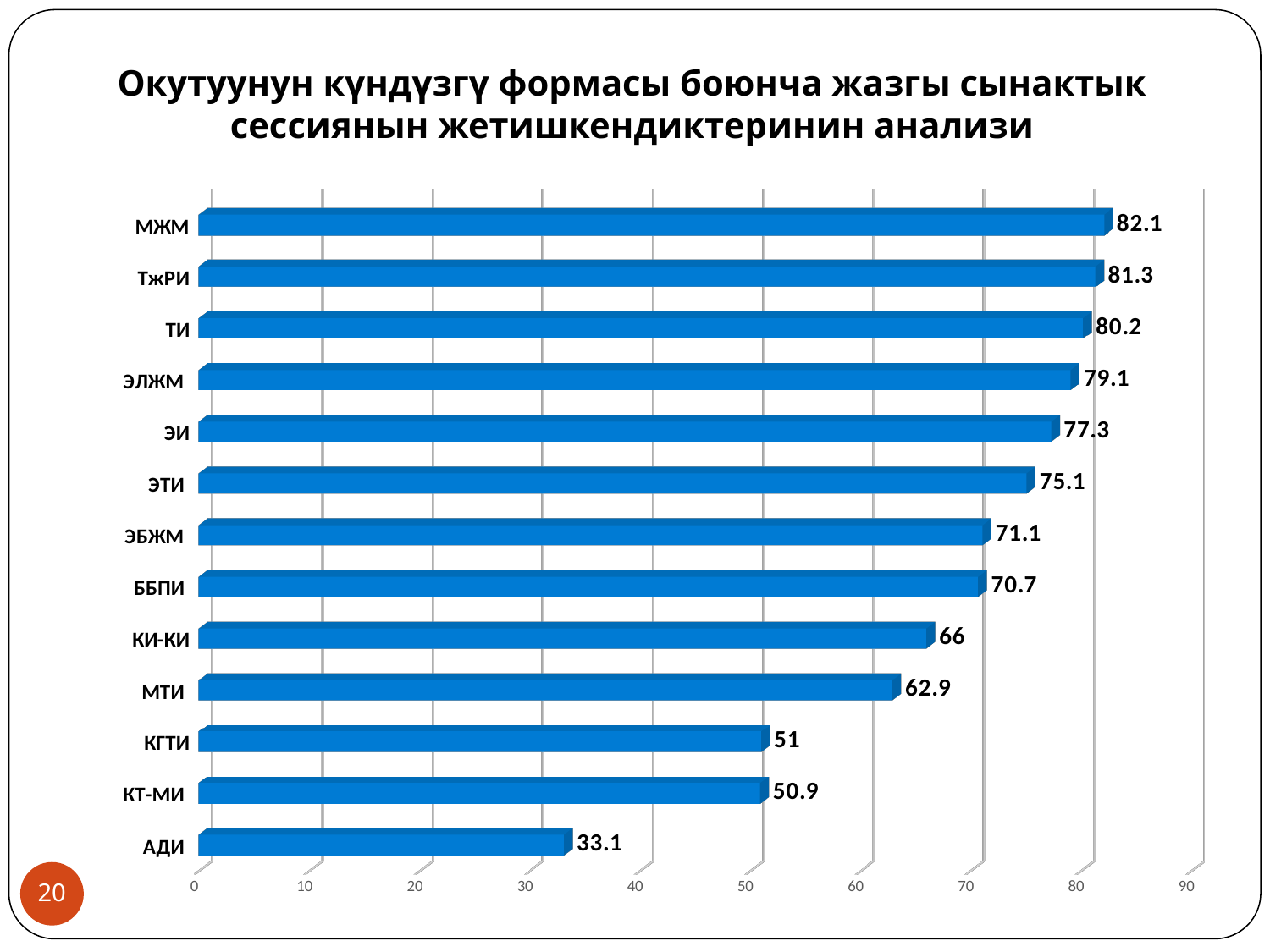
Which is larger, the value for МТИ or the value for КГТИ? МТИ What is the difference between the values for МЖМ and АДИ? 49 What kind of chart is shown on the slide? bar chart How many categories are shown in the chart? 13 What is the value for КИ-КИ? 66 What is the value for МЖМ? 82.1 What is the value for АДИ? 33.1 Which category has the highest value? МЖМ Which category has the lowest value? АДИ What is the difference between the values for ЭТИ and ЭБЖМ? 4 Is the value for ББПИ greater or less than 60? greater What is the value for ТжРИ? 81.3